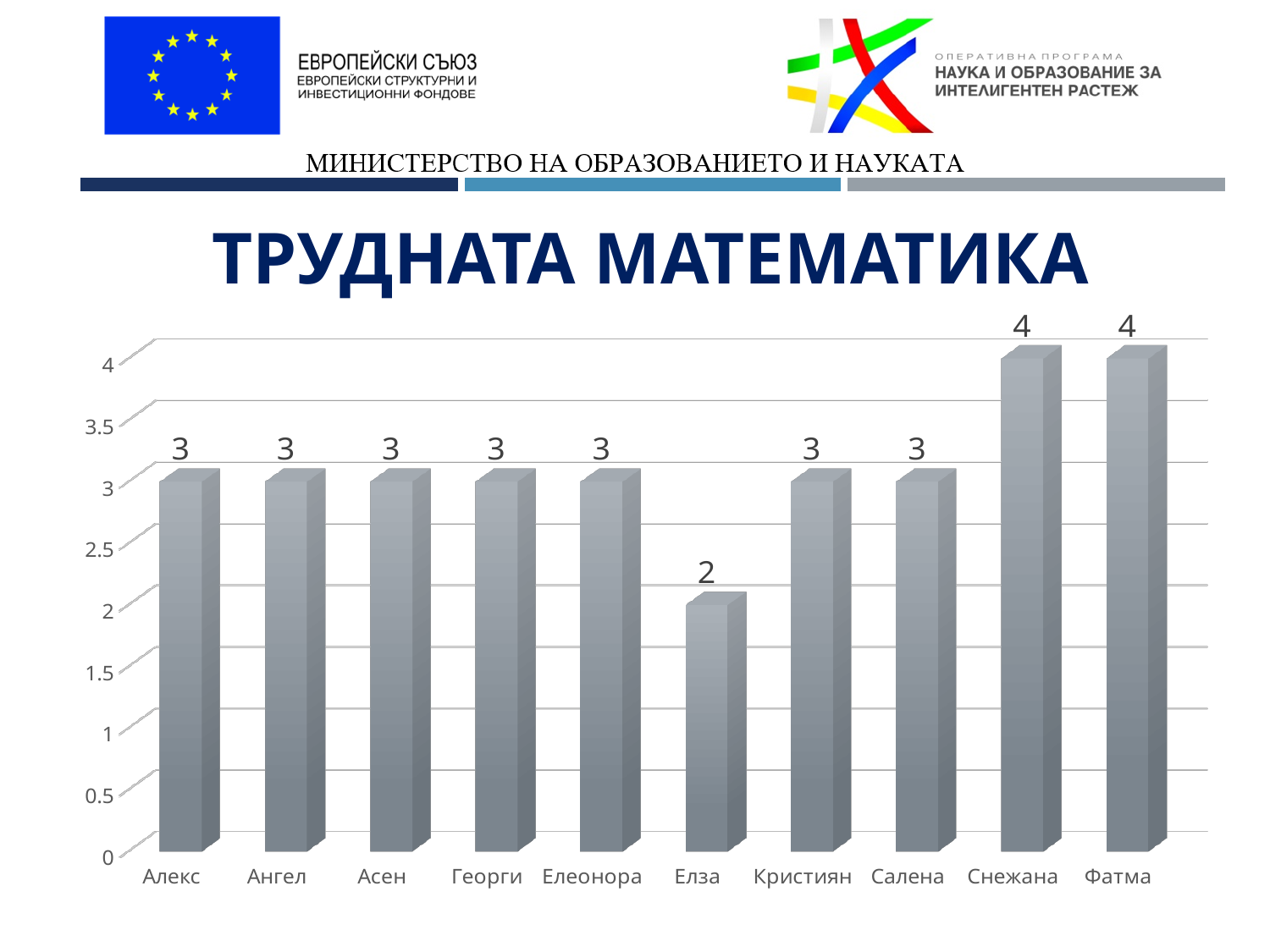
What is the value for Георги? 3 What is the highest value shown on the vertical axis? 4 What kind of chart is shown on the slide? bar chart What is the value for Елза? 2 Which is larger, the value for Снежана or the value for Кристиян? Снежана How many categories are shown on the x axis? 10 What is the value for Снежана? 4 What is the title of the chart? ТРУДНАТА МАТЕМАТИКА What is the difference between the values for Фатма and Елза? 2 How many categories have a value of 4? 2 Is the value for Елза greater or less than 2.5? less Which category has the lowest value? Елза